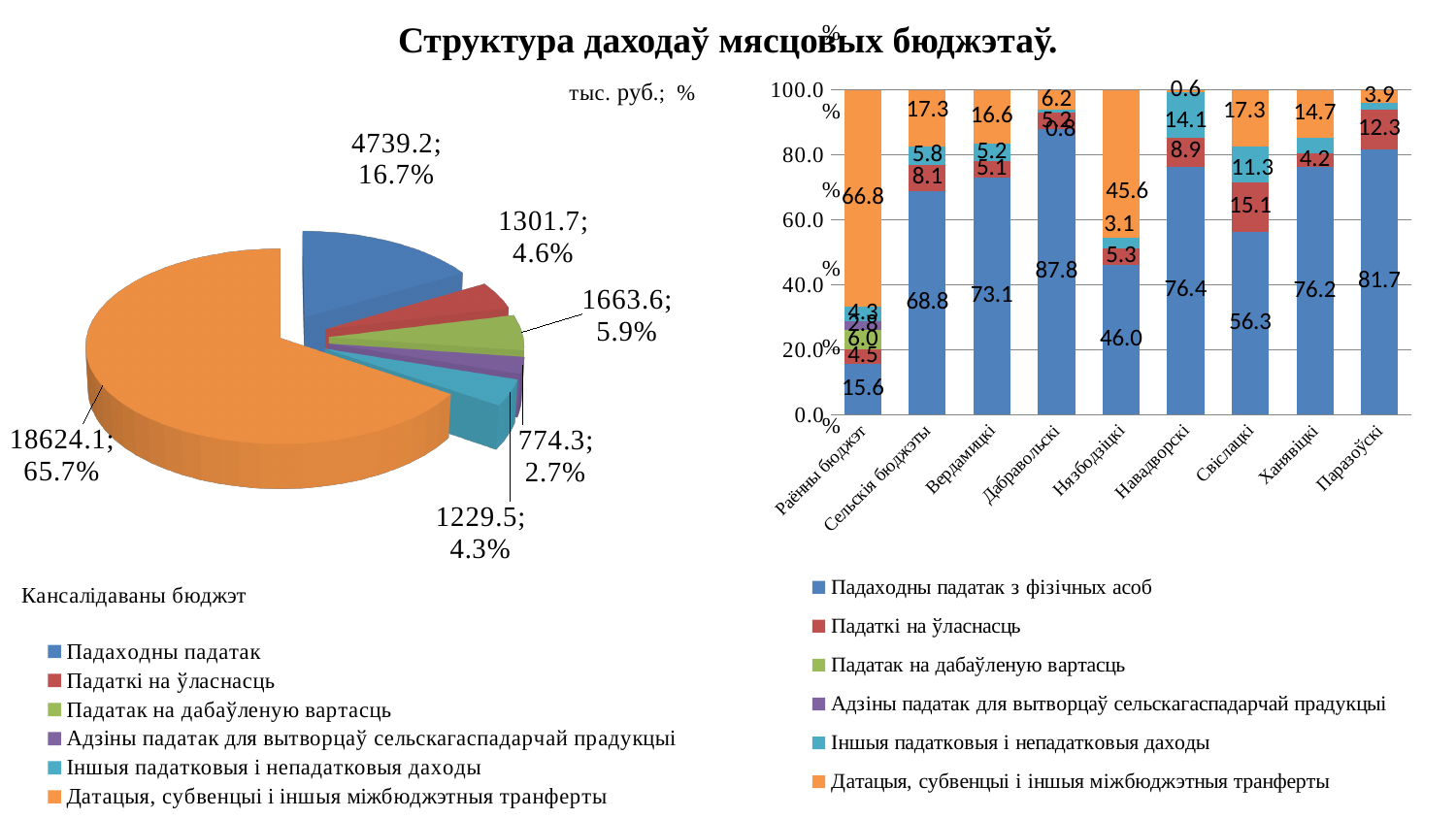
In the right bar chart, how many categories are shown on the x axis? 9 In the right bar chart, which is larger: the Датацыі value for Раённы бюджэт (66.8) or for Нязбодзіцкі (45.6)? Раённы бюджэт (66.8) In the pie chart, what is the difference between the values 1663.6 and 1301.7? 361.9 What kind of chart is the left chart (Кансалідаваны бюджэт)? pie chart In the pie chart, which slice is the smallest? Адзіны падатак для вытворцаў сельскагаспадарчай прадукцыі (774.3; 2.7%) In the right bar chart, which category has the lowest value for Падаходны падатак з фізічных асоб? Раённы бюджэт (15.6) In the right bar chart, what is the difference between the Падаходны падатак з фізічных асоб values for Паразоўскі and Свіслацкі? 25.4 How many series does the legend of the right bar chart list? 6 In the right bar chart, what is the value of Падаходны падатак з фізічных асоб for Дабравольскі? 87.8 What kind of chart is the right chart? stacked bar chart In the pie chart, what value is shown for the blue slice (Падаходны падатак)? 4739.2; 16.7% In the pie chart, what share does the largest slice (Датацыі, субвенцыі і іншыя міжбюджэтныя трансферты) have? 65.7%